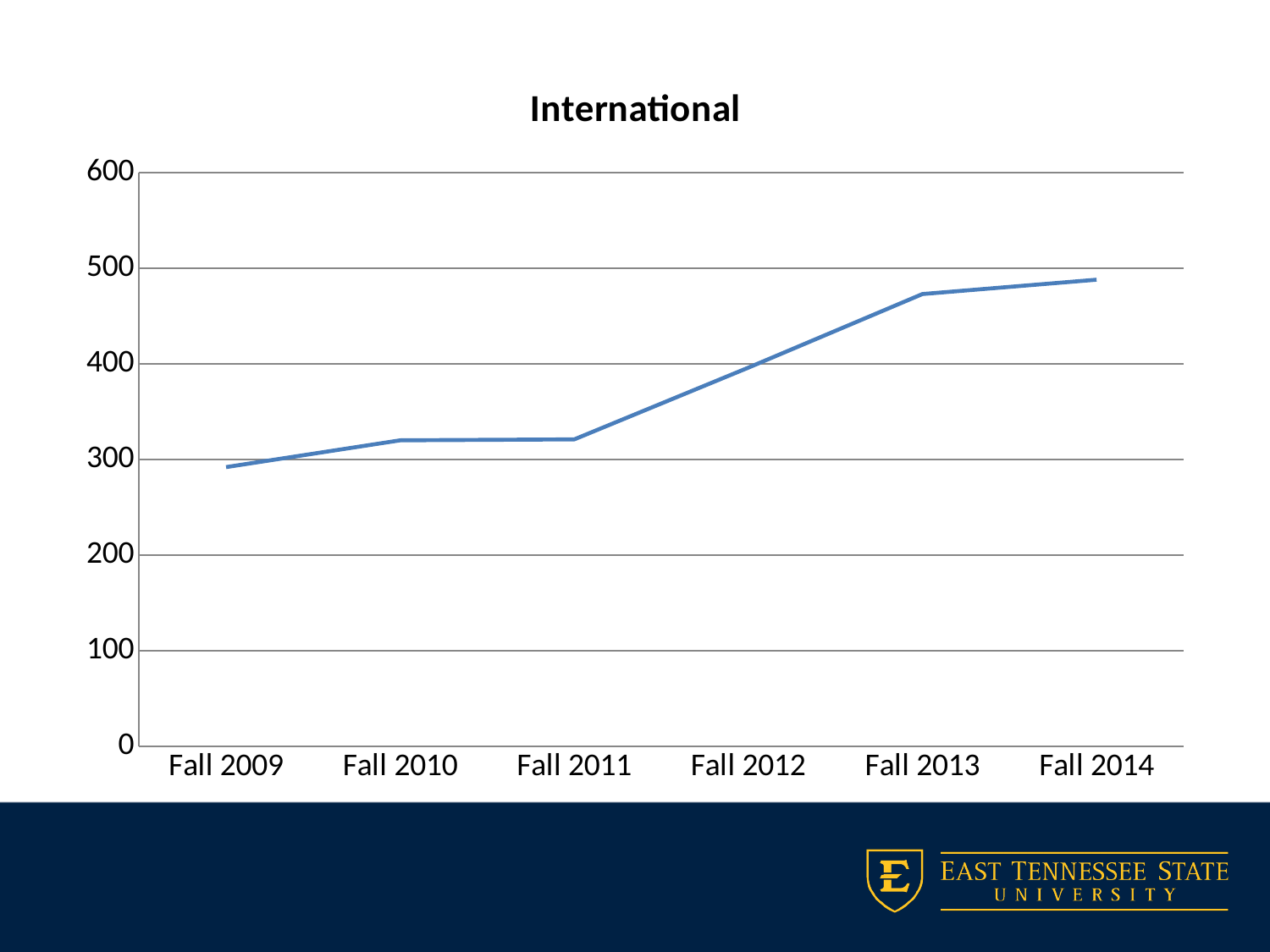
Is the value for Fall 2013 greater or less than 400? greater How many points (terms) are plotted along the x axis? 6 Which term has the highest value? Fall 2014 Is the value for Fall 2014 greater or less than 500? less What kind of chart is shown on the slide? line chart What is the title of the chart? International Is the value for Fall 2009 greater or less than 300? less Which is larger, the value for Fall 2009 or the value for Fall 2012? Fall 2012 Which is larger, the value for Fall 2013 or the value for Fall 2010? Fall 2013 Do the values generally rise or fall from Fall 2009 to Fall 2014? rise Which term has the lowest value? Fall 2009